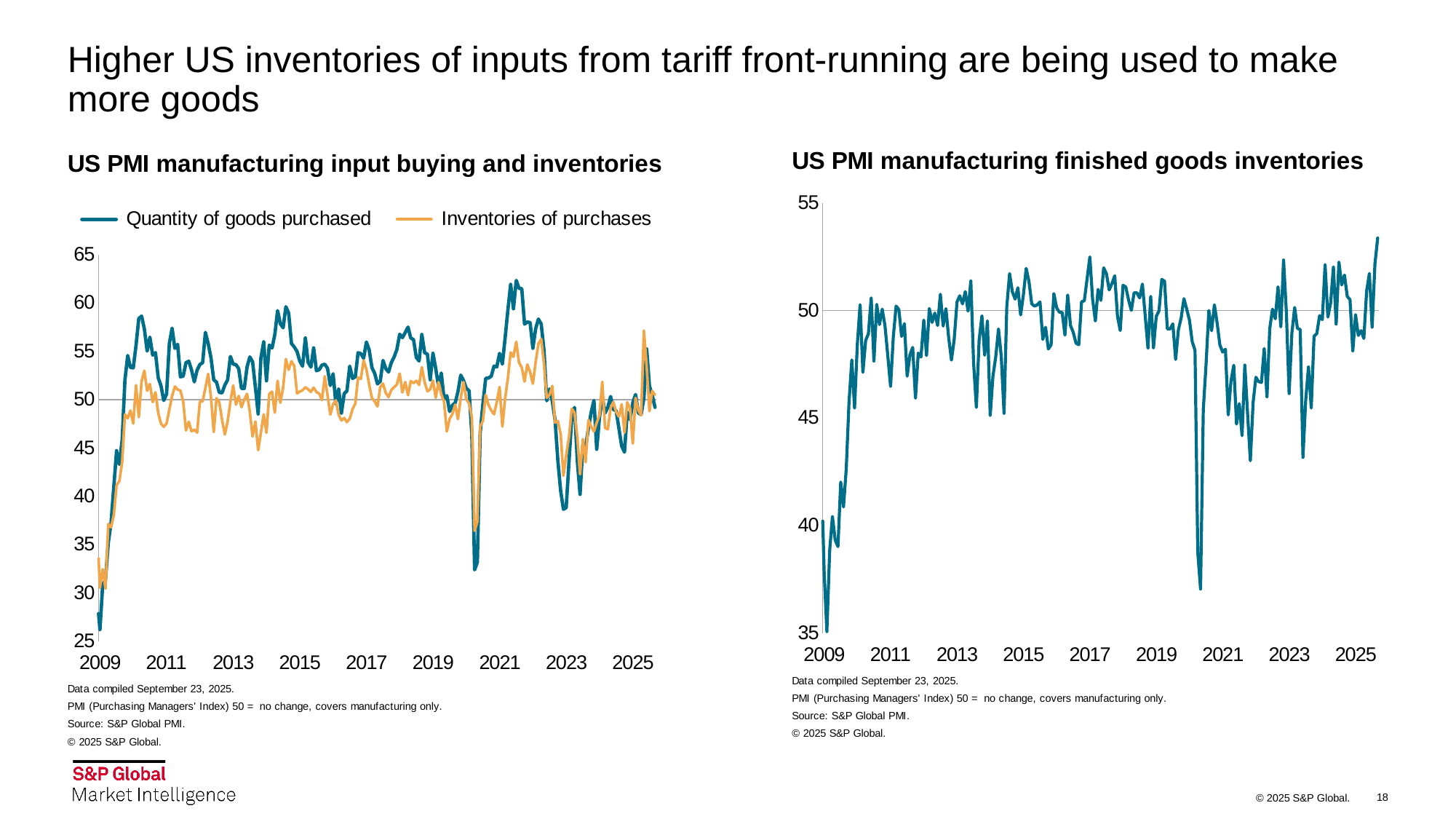
In the 'US PMI manufacturing finished goods inventories' chart, is the lowest value in 2020 greater or less than 40? less What kind of chart is the 'US PMI manufacturing finished goods inventories' chart? line chart In the 'US PMI manufacturing finished goods inventories' chart, is the value at the start of 2009 greater or less than 40? less In the 'US PMI manufacturing input buying and inventories' chart, which series is drawn in teal? Quantity of goods purchased In the 'US PMI manufacturing input buying and inventories' chart, is the peak value of Quantity of goods purchased in 2021 greater or less than 60? greater In the 'US PMI manufacturing finished goods inventories' chart, does the value rise or fall from the start of 2009 to 2010? rise What kind of chart is the 'US PMI manufacturing input buying and inventories' chart? line chart How many series does the legend of the 'US PMI manufacturing input buying and inventories' chart list? 2 In the 'US PMI manufacturing input buying and inventories' chart, which series is drawn in orange? Inventories of purchases